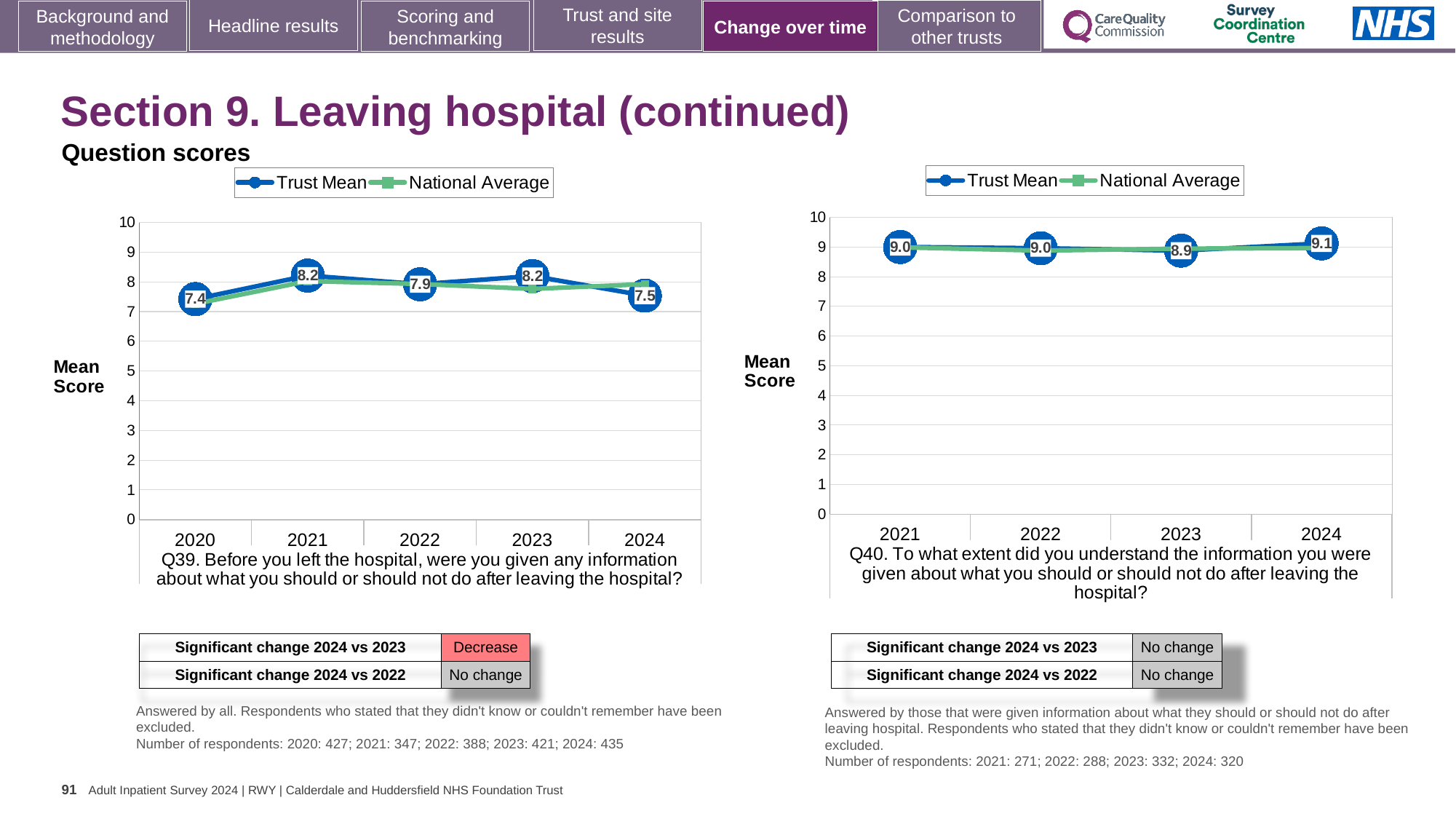
How many years are plotted on the x axis of the Q39 chart on the left? 5 In the Q40 chart on the right, is the National Average value for 2021 greater or less than 8? greater What type of chart is the Q39 chart on the left? Line chart In the Q39 chart on the left, what is the Trust Mean score for 2020? 7.4 In the Q40 chart on the right, which year has the highest Trust Mean score? 2024 In the Q39 chart on the left, is the Trust Mean score higher in 2021 or in 2022? 2021 In the Q39 chart on the left, what is the difference between the Trust Mean scores for 2023 and 2024? 0.7 In the Q39 chart on the left, what is the Trust Mean score for 2024? 7.5 How many series does the legend of the Q40 chart on the right list? 2 In the Q40 chart on the right, which year has the lowest Trust Mean score? 2023 In the Q39 chart on the left, which year has the lowest Trust Mean score? 2020 In the Q40 chart on the right, what is the Trust Mean score for 2024? 9.1